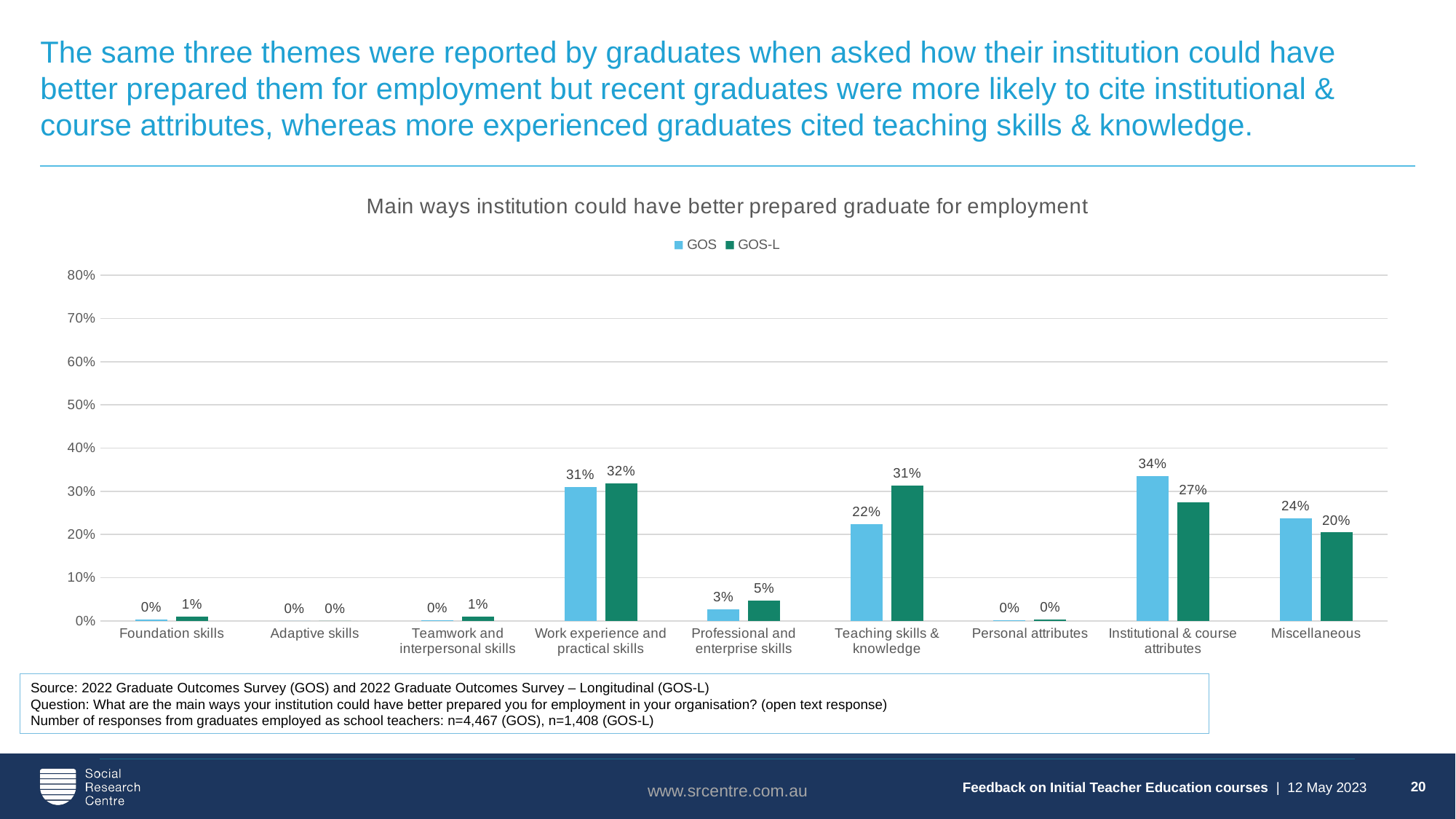
What is the GOS value for Institutional & course attributes? 34% What is the GOS-L value for Professional and enterprise skills? 5% Which category has the highest GOS-L value? Work experience and practical skills What kind of chart is shown on the slide? Bar chart For Miscellaneous, which series has the larger value, GOS or GOS-L? GOS How many series does the legend list? 2 What is the GOS-L value for Teaching skills & knowledge? 31% What is the difference between the GOS and GOS-L values for Teaching skills & knowledge? 9% How many categories are shown on the x axis? 9 Is the GOS value for Work experience and practical skills greater or less than 20%? greater What is the difference between the GOS and GOS-L values for Institutional & course attributes? 7% Which category has the highest GOS value? Institutional & course attributes